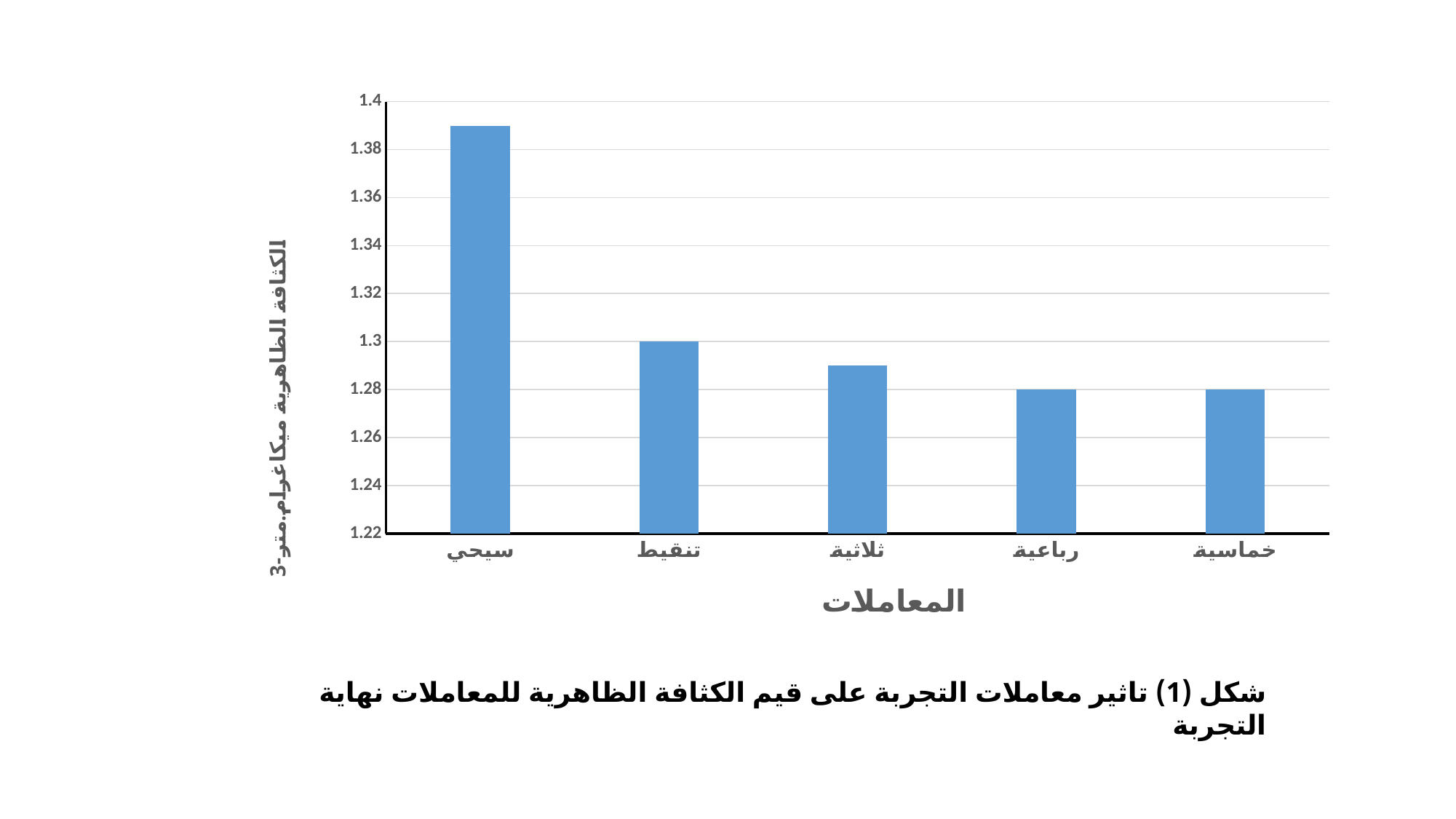
What is the apparent density value for تنقيط? 1.3 What is the title of the x axis? المعاملات Is the value for ثلاثية greater or less than 1.3? less What kind of chart is shown on the slide? bar chart What is the apparent density value for رباعية? 1.28 What is the difference between the values for تنقيط and رباعية? 0.02 Is the value for سيحي greater or less than 1.36? greater Which treatment has the highest apparent density value? سيحي Do the values generally rise or fall moving from left to right along the x axis? fall Which has a larger value, سيحي or تنقيط? سيحي What is the apparent density value for خماسية? 1.28 How many categories (treatments) are plotted on the x axis? 5